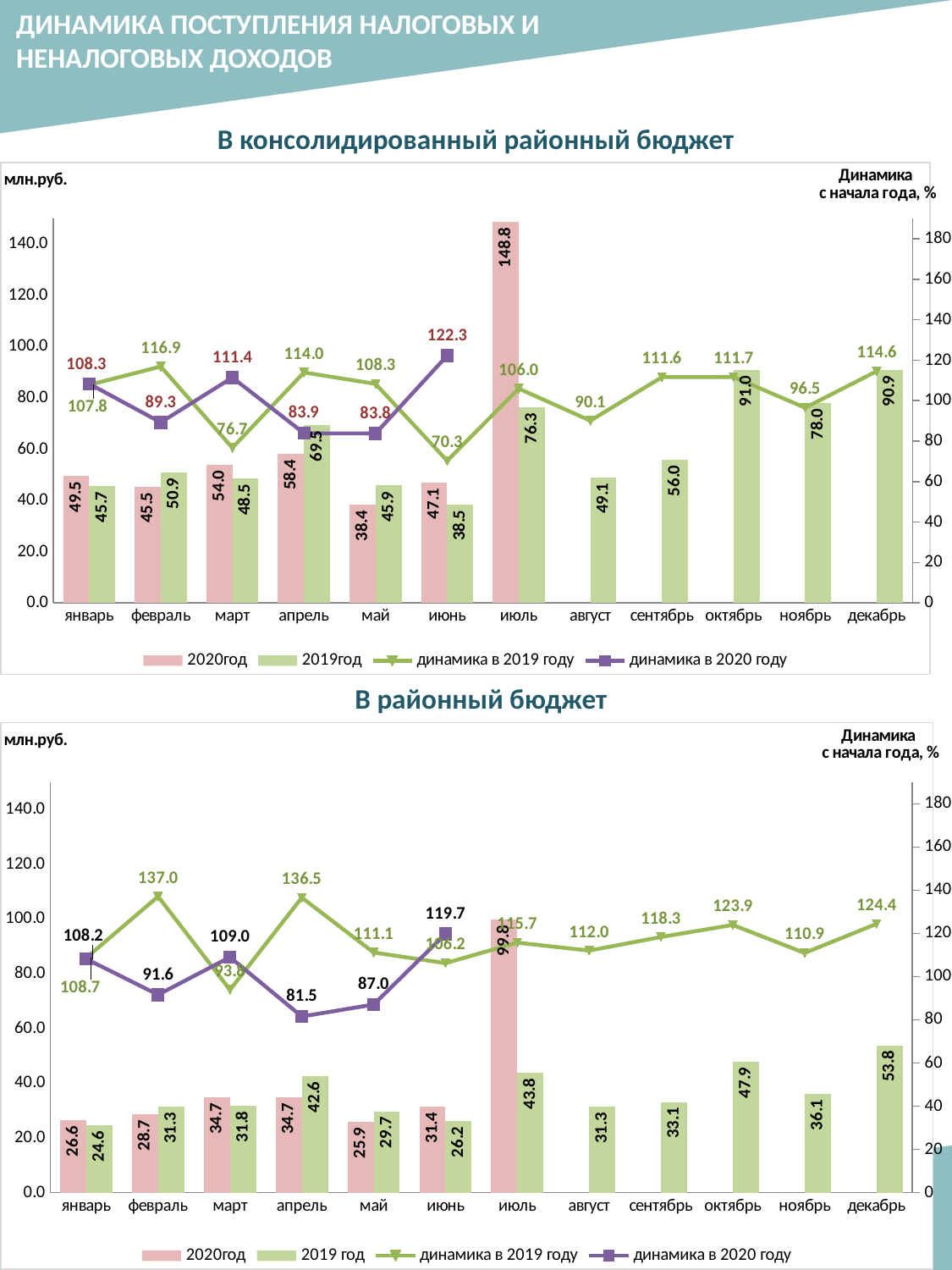
In the chart 'В консолидированный районный бюджет', what is the value of the 2020год bar for июль? 148.8 In the chart 'В консолидированный районный бюджет', what is the difference between the 2020год and 2019год bars for апрель? 11.1 In the chart 'В районный бюджет', how many months are shown on the x axis? 12 In the chart 'В районный бюджет', what is the value of 'динамика в 2019 году' for февраль? 137.0 In the chart 'В районный бюджет', which month has the lowest 2020год bar? май In the chart 'В консолидированный районный бюджет', what is the value of 'динамика в 2020 году' for июнь? 122.3 In the chart 'В консолидированный районный бюджет', which month has the highest 2020год bar? июль In the chart 'В консолидированный районный бюджет', how many series does the legend list? 4 In the chart 'В консолидированный районный бюджет', what is the value of the 2019год bar for октябрь? 91.0 What kind of chart is 'В районный бюджет'? Combined bar and line chart In the chart 'В районный бюджет', what is the value of the 2019 год bar for декабрь? 53.8 In the chart 'В районный бюджет', which is larger for март: the 2020год bar or the 2019 год bar? 2020год